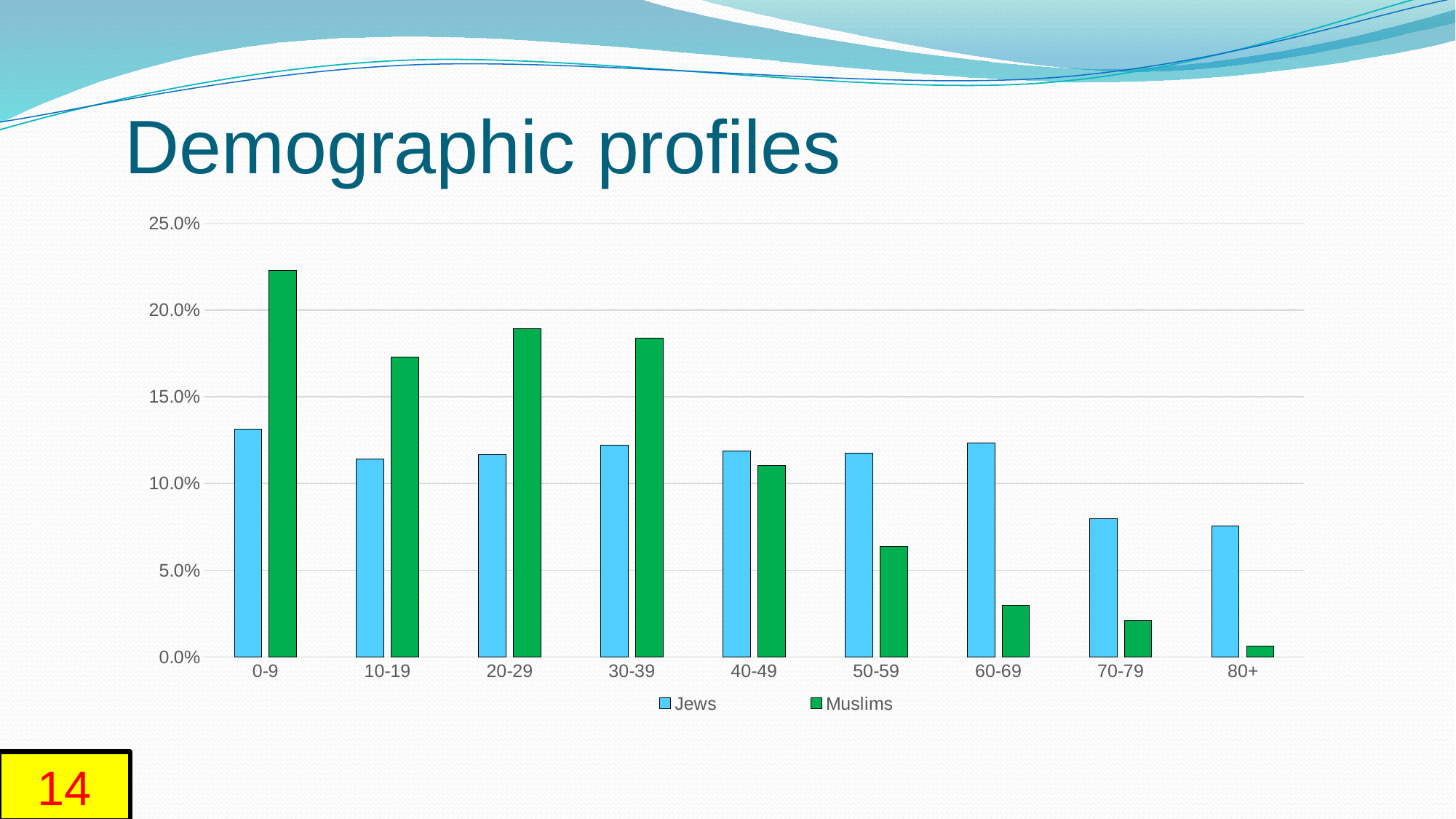
Is the value for Muslims in the 0-9 age group greater or less than 20.0%? greater How many series does the chart's legend list? 2 Is the value for Muslims in the 20-29 age group greater or less than 15.0%? greater In the 60-69 age group, which series has the larger value, Jews or Muslims? Jews Do the values for Muslims generally rise or fall from the 0-9 age group to the 80+ age group? fall Is the value for Jews in the 70-79 age group greater or less than 10.0%? less How many age groups are shown on the x axis of the chart? 9 Which age group has the highest value for Muslims? 0-9 Which age group has the lowest value for Muslims? 80+ Which series is shown in green in the chart? Muslims What kind of chart is shown on the slide? Bar chart